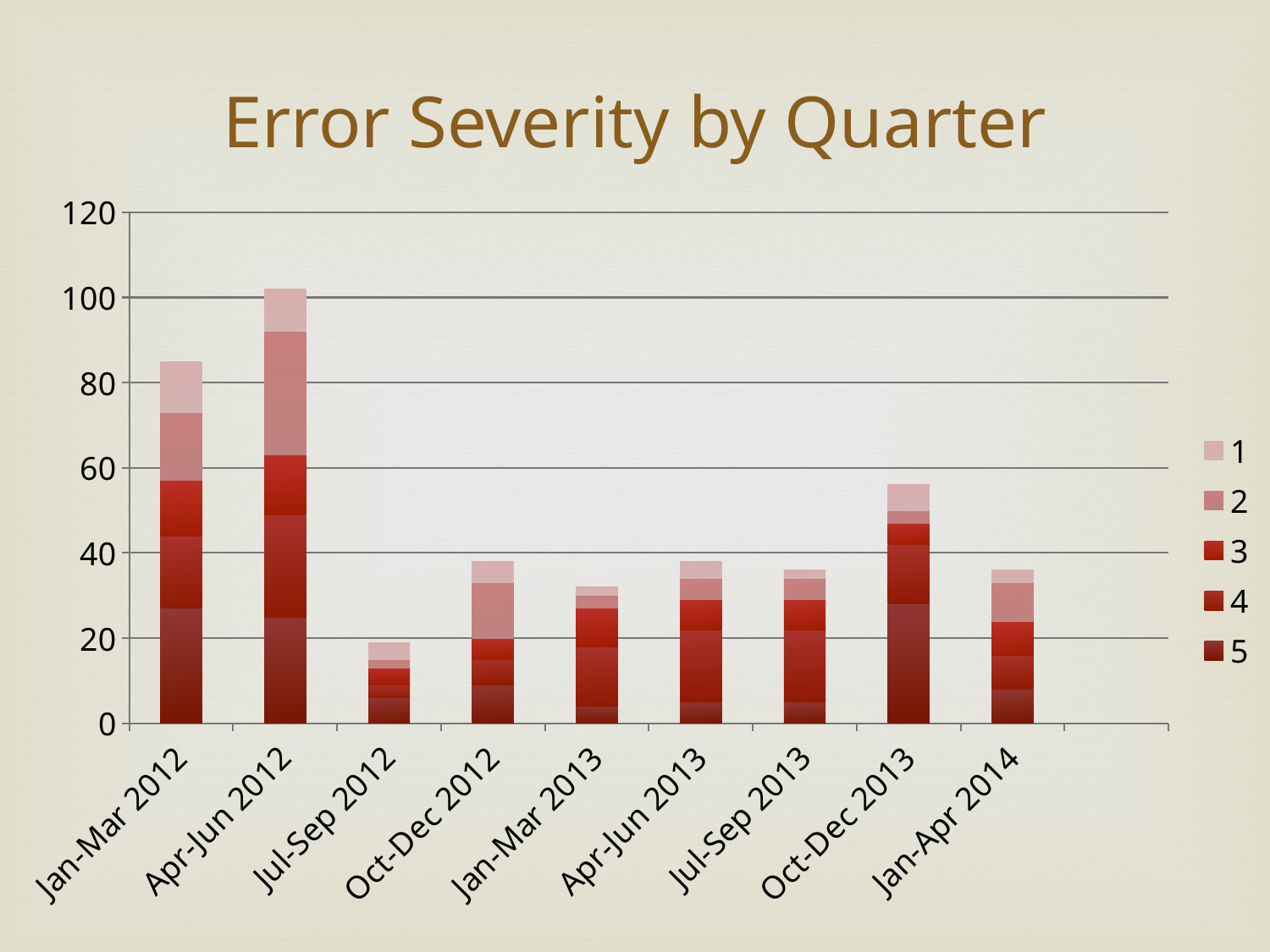
Is the total for Oct-Dec 2013 greater or less than 40? greater What kind of chart is shown on the slide? Stacked bar chart How many series does the legend list? 5 Is the total for Jan-Apr 2014 greater or less than 40? less How many quarters are shown on the x axis? 9 Is the total for Jul-Sep 2012 greater or less than 40? less What is the title of the chart? Error Severity by Quarter Does the total bar height rise or fall from Apr-Jun 2012 to Jul-Sep 2012? fall Which has the larger total bar, Jan-Mar 2012 or Oct-Dec 2013? Jan-Mar 2012 Which quarter has the highest total bar? Apr-Jun 2012 Which quarter has the lowest total bar? Jul-Sep 2012